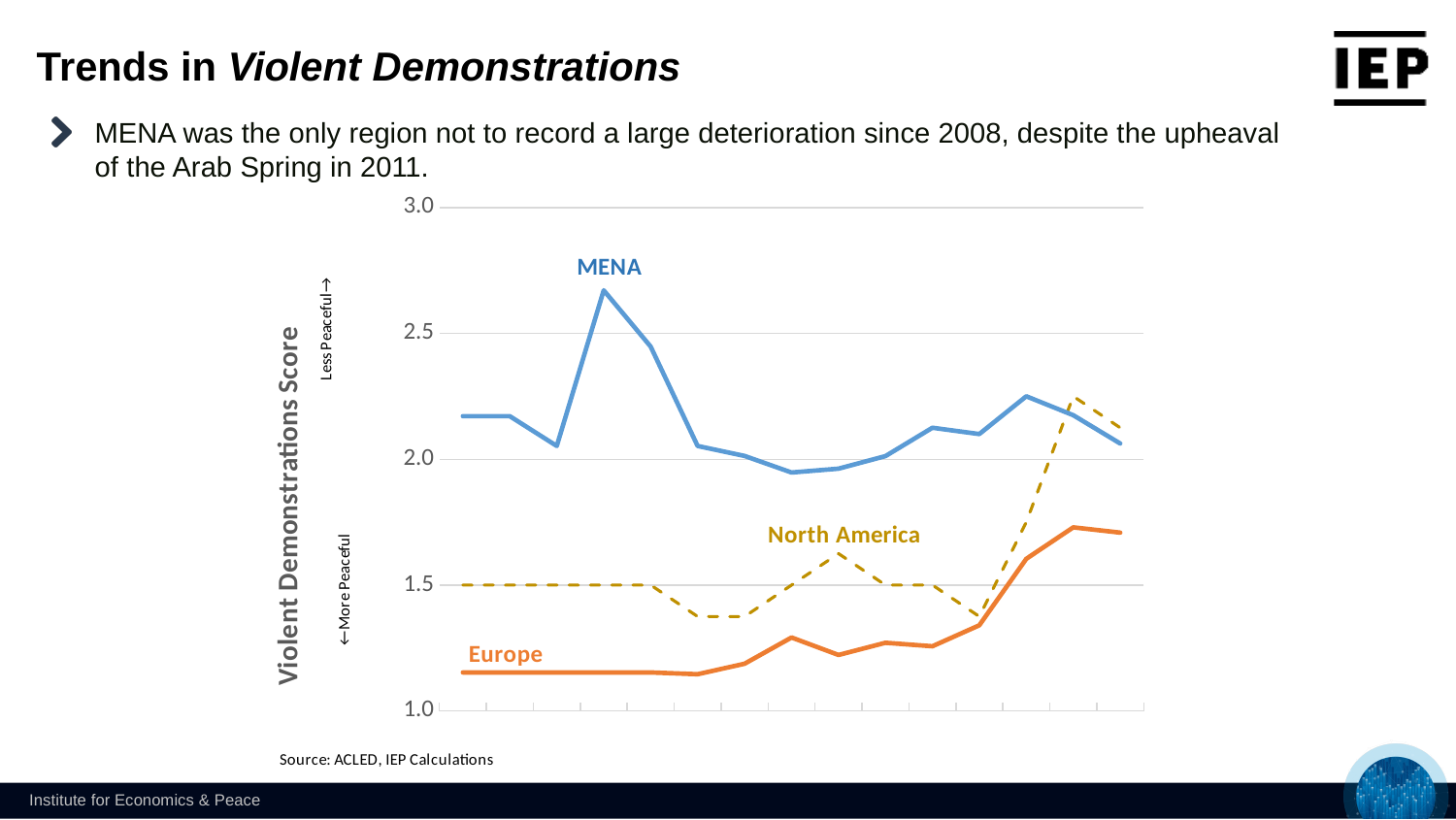
Is the value for Europe at the end of the chart greater or less than 1.5? greater How many series are plotted on the chart? 3 Is the value for North America at the end of the chart greater or less than 2.0? greater Which series is drawn with a dashed line? North America Which series has the lowest value at the start of the chart? Europe Is the peak value for MENA greater or less than 2.5? greater Does the Europe series rise or fall overall from left to right? Rise What is the label on the vertical axis of the chart? Violent Demonstrations Score What kind of chart is shown on the slide? Line chart Which series reaches the highest value on the chart? MENA At the end of the chart, which is higher: Europe or North America? North America